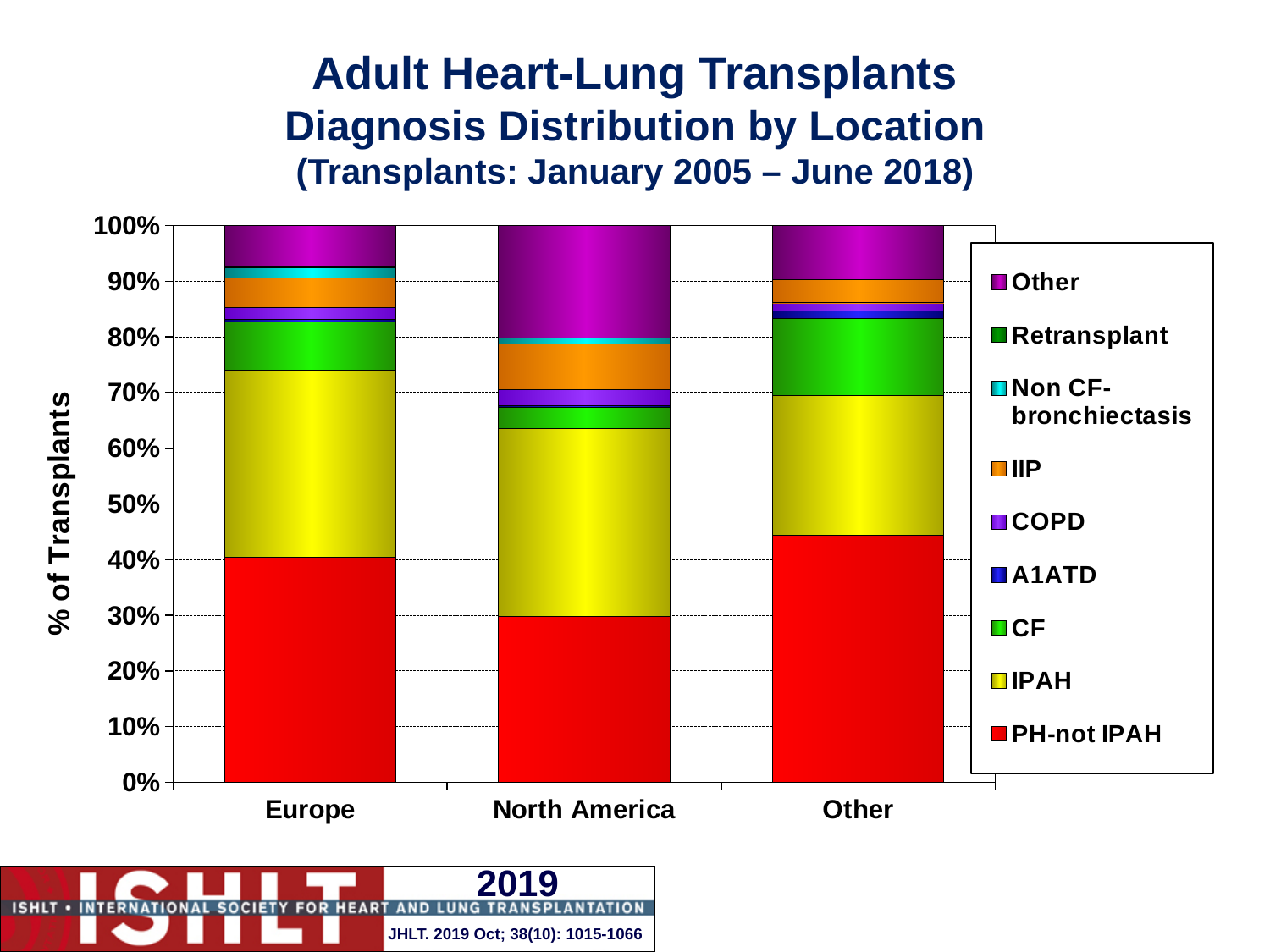
Which diagnosis category is shown in red in the legend? PH-not IPAH Is the PH-not IPAH share for Other greater or less than 50%? less What is the total height of the stacked bar for Europe? 100% What is the label on the y axis of the chart? % of Transplants Which location has the smallest PH-not IPAH share? North America Is the PH-not IPAH share for Europe greater or less than 30%? greater Is the IPAH segment larger for Europe or for Other? Europe How many diagnosis categories does the legend list? 9 Is the PH-not IPAH share larger for Europe or for North America? Europe Which location has the largest 'Other' diagnosis segment? North America What kind of chart is shown on the slide? Stacked bar chart How many locations are shown on the x axis of the chart? 3